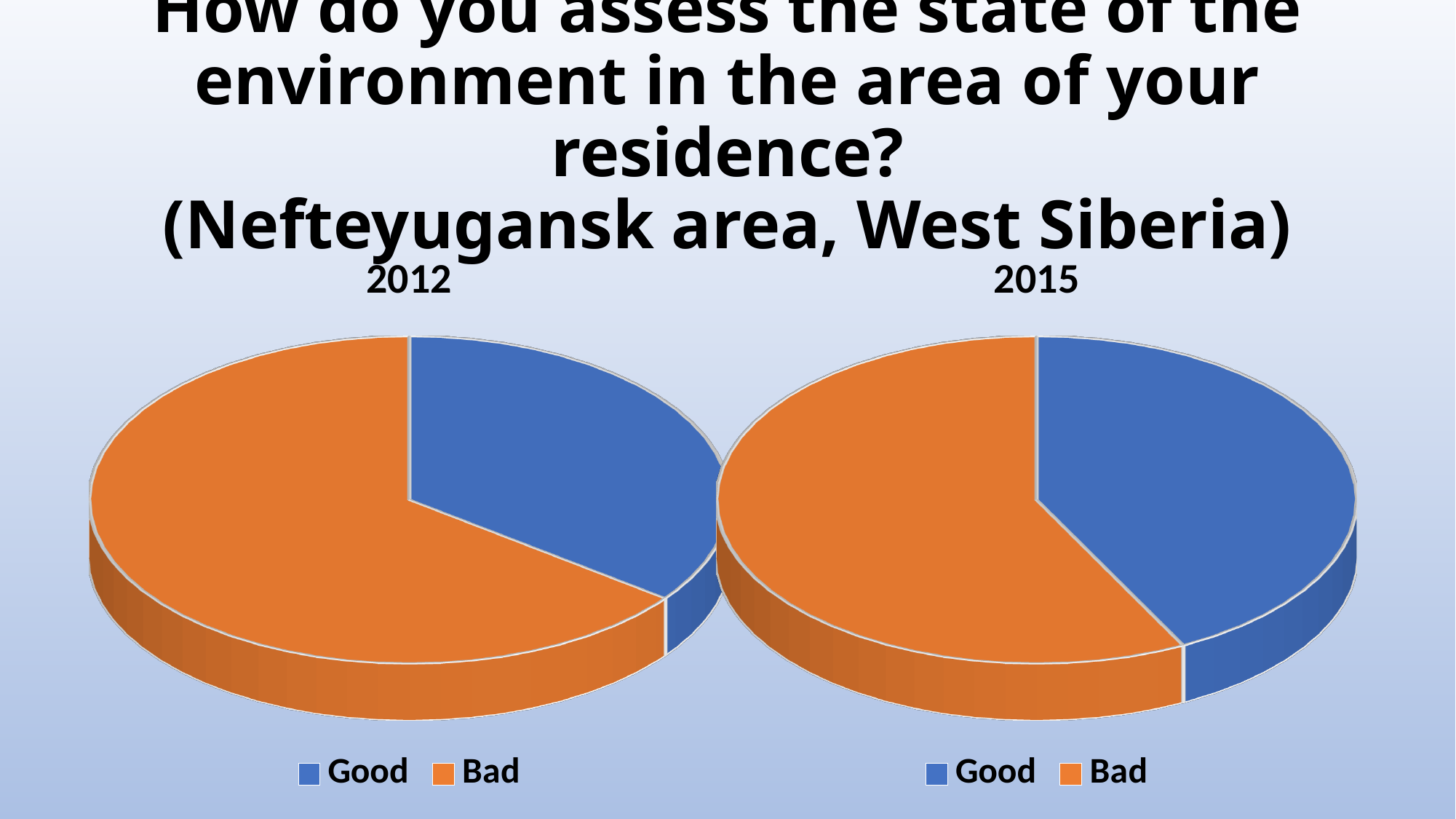
In the 2015 pie chart, which category has the largest slice? Bad In the 2012 pie chart, which category has the largest slice? Bad In the 2012 pie chart, which slice is larger, Good or Bad? Bad In the 2015 pie chart, which category has the smallest slice? Good In the 2012 pie chart, which category has the smallest slice? Good What kind of chart is used for the 2012 data on the slide? Pie chart How many slices does the 2015 pie chart have? 2 What are the titles of the two pie charts on the slide? 2012 and 2015 In the 2015 pie chart, which slice is larger, Good or Bad? Bad What colour represents the Good category in the pie charts? Blue How many pie charts are shown on the slide? 2 How many entries does the legend of the 2012 pie chart list? 2